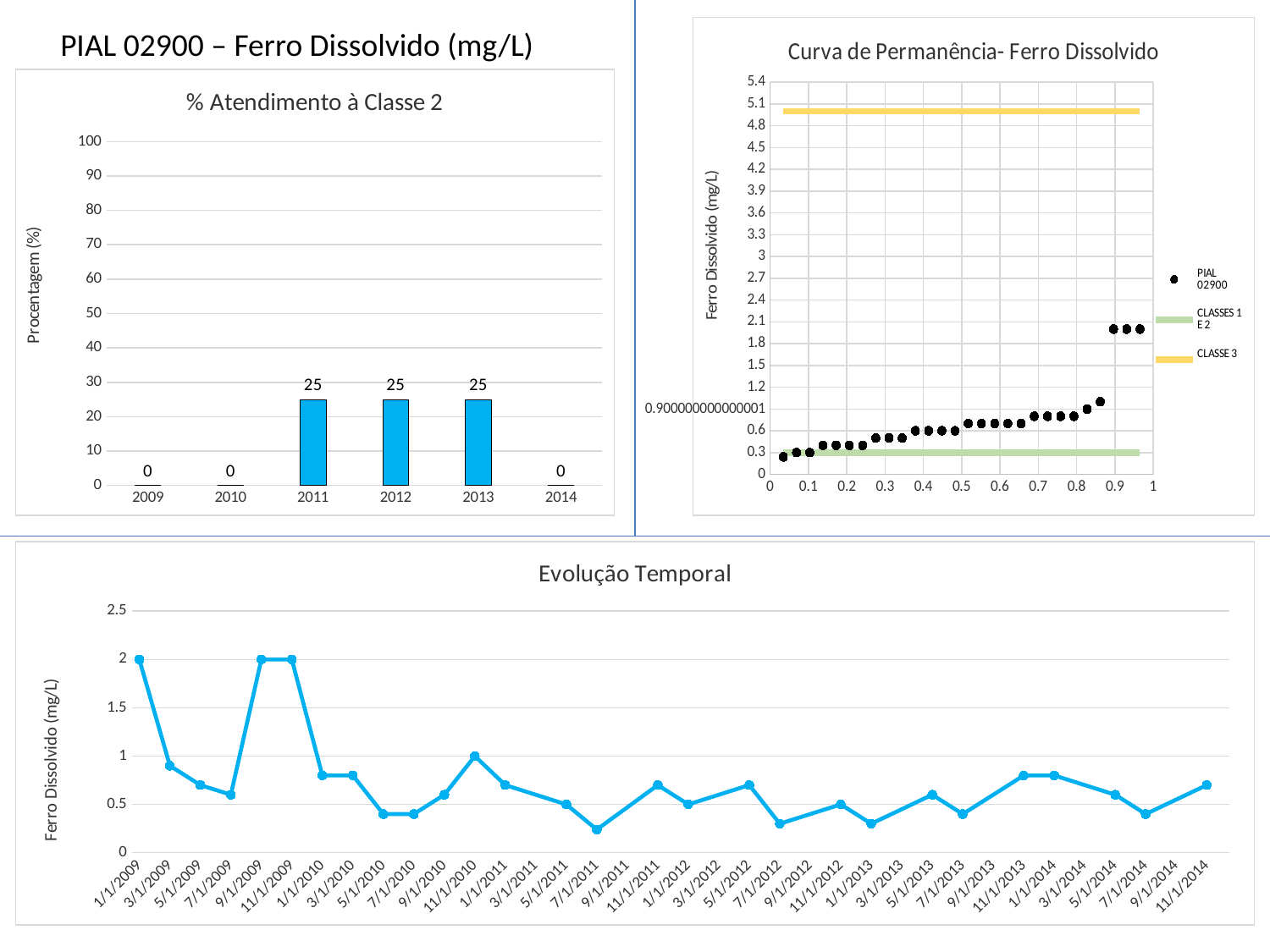
In the '% Atendimento à Classe 2' chart, what is the value for 2011? 25 In the '% Atendimento à Classe 2' chart, how many years are shown on the x axis? 6 In the 'Curva de Permanência- Ferro Dissolvido' chart, is the CLASSE 3 line greater or less than 4.5? greater What kind of chart is 'Evolução Temporal'? line chart In the 'Curva de Permanência- Ferro Dissolvido' chart, what is the label of the series drawn as a yellow line? CLASSE 3 What kind of chart is '% Atendimento à Classe 2'? bar chart In the '% Atendimento à Classe 2' chart, which is larger, the value for 2013 or the value for 2014? 2013 In the '% Atendimento à Classe 2' chart, what is the difference between the values for 2012 and 2010? 25 In the 'Evolução Temporal' chart, is the value for 7/1/2011 greater or less than 0.5? less In the '% Atendimento à Classe 2' chart, what is the value for 2014? 0 In the 'Evolução Temporal' chart, what is the value for 1/1/2009? 2 In the 'Curva de Permanência- Ferro Dissolvido' chart, how many series does the legend list? 3